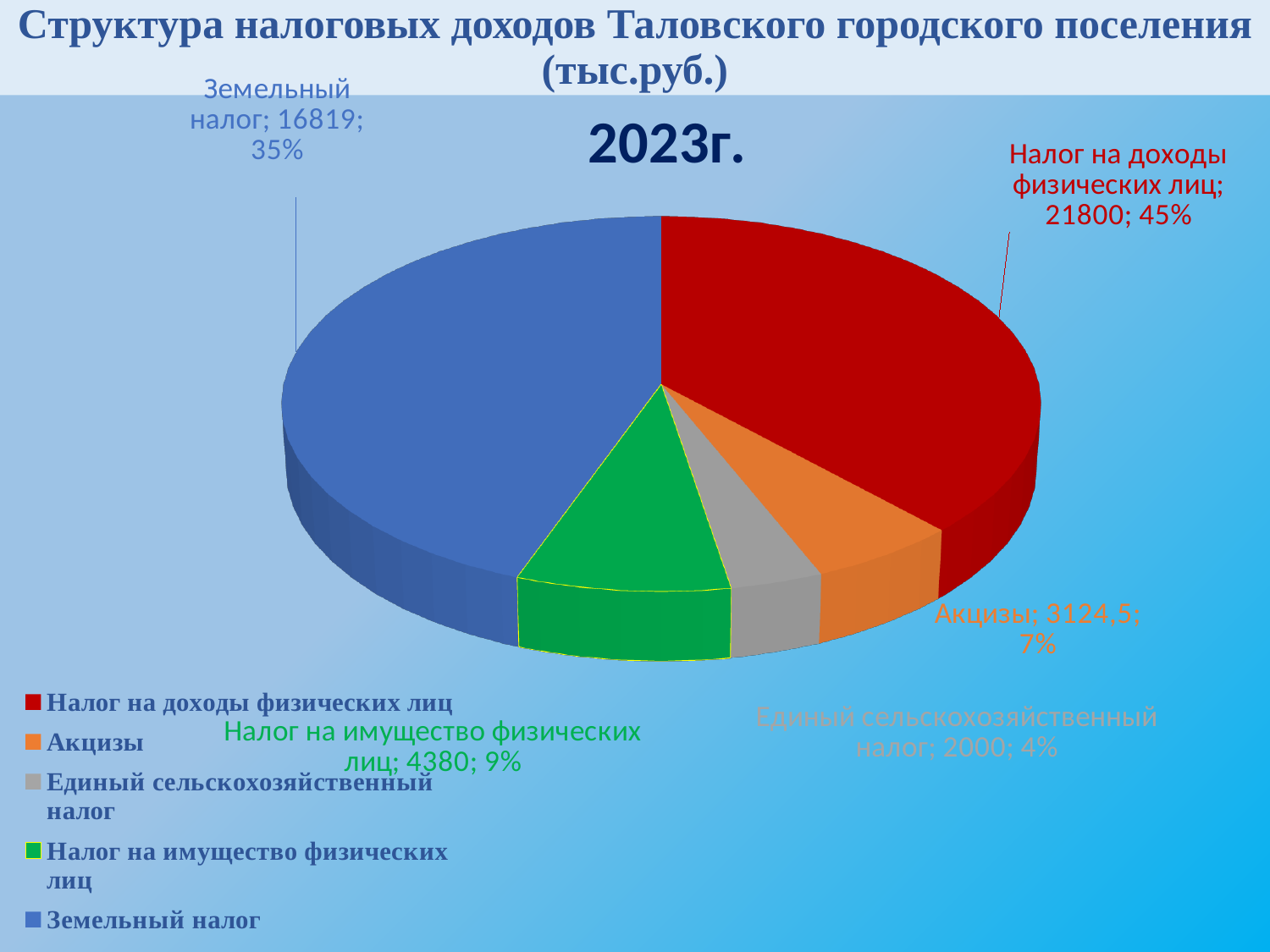
What is the value for Налог на имущество физических лиц? 4380 What share of the pie does Единый сельскохозяйственный налог represent? 4% What share of the pie does Земельный налог represent? 35% What is the value for Налог на доходы физических лиц? 21800 Which category has the smallest slice? Единый сельскохозяйственный налог What is the difference between the values for Налог на доходы физических лиц and Земельный налог? 4981 What kind of chart is shown on the slide? pie chart What is the value for Земельный налог? 16819 How many categories does the legend list? 5 Which is larger, the value for Акцизы or the value for Налог на имущество физических лиц? Налог на имущество физических лиц What is the value for Акцизы? 3124,5